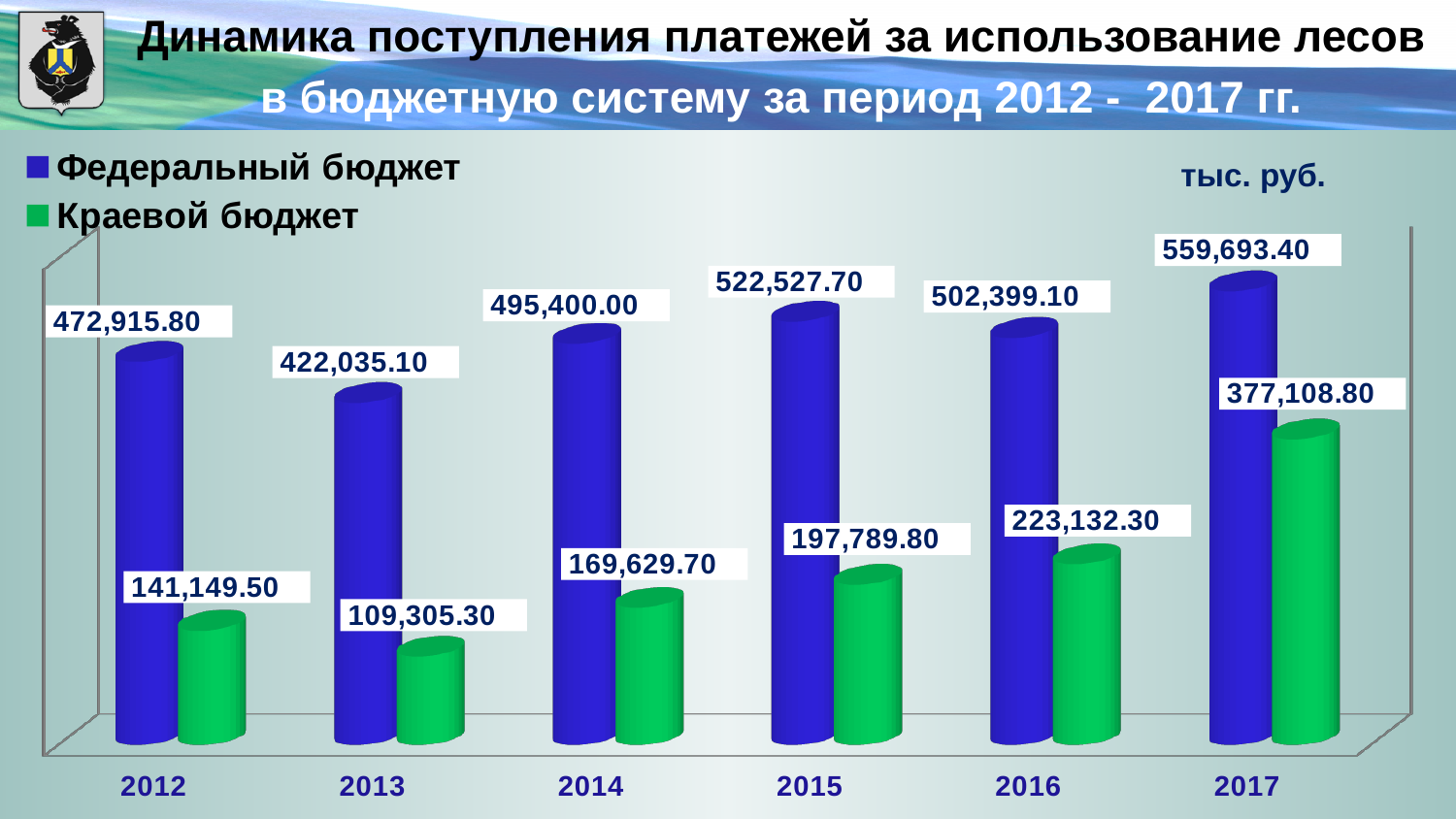
What is the difference between the Федеральный бюджет values in 2015 and 2016? 20,128.60 How many years are shown on the x axis? 6 In which year is the Краевой бюджет value lowest? 2013 In which year is the Федеральный бюджет value lowest? 2013 What is the value for Краевой бюджет in 2013? 109,305.30 In which year is the Федеральный бюджет value highest? 2017 What is the value for Федеральный бюджет in 2015? 522,527.70 How many series does the legend list? 2 Which is larger: the Краевой бюджет value in 2014 or in 2016? 2016 What is the difference between the Федеральный бюджет and Краевой бюджет values in 2017? 182,584.60 What is the value for Краевой бюджет in 2017? 377,108.80 What kind of chart is shown on the slide? Bar chart